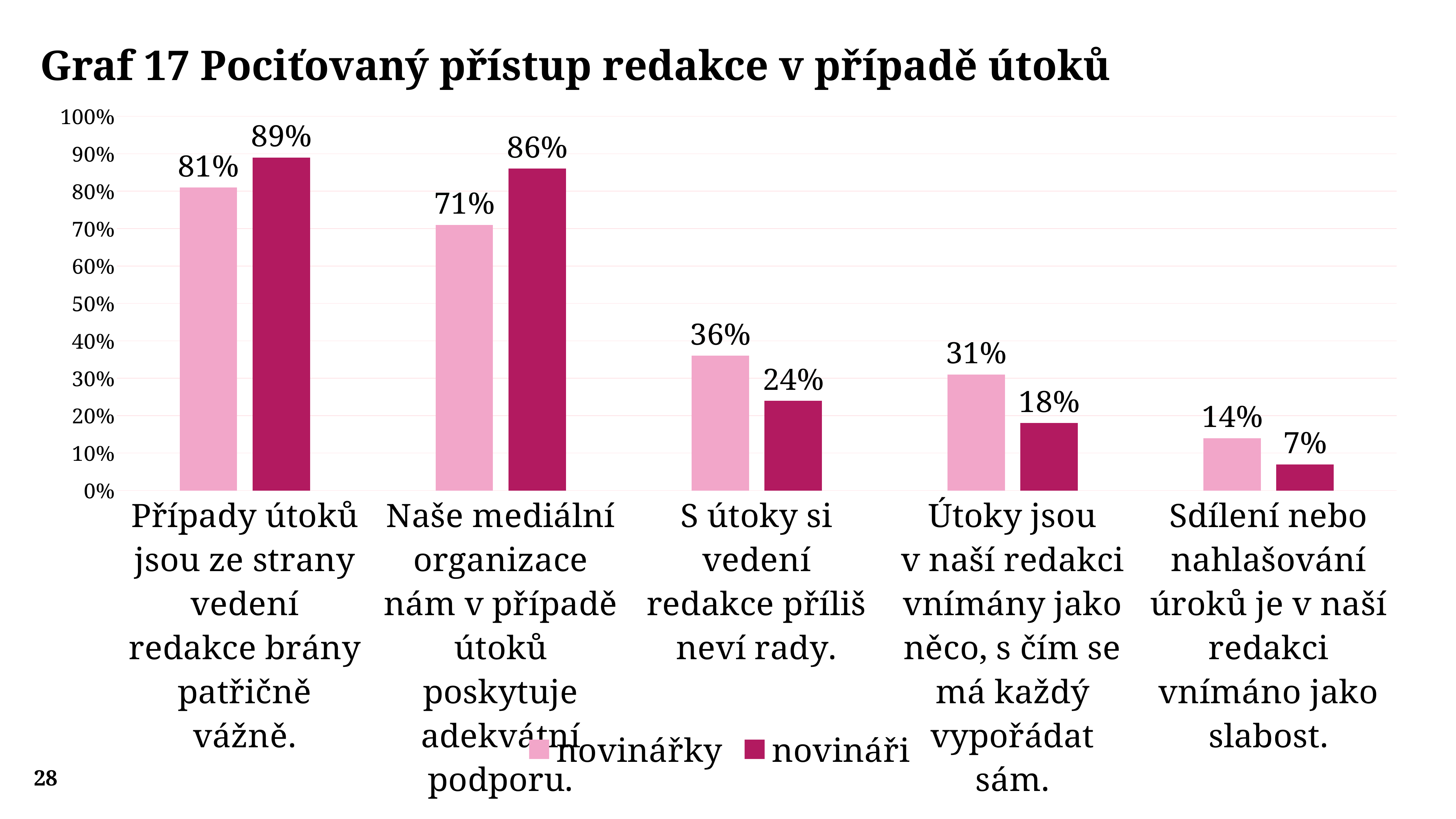
Is the value for novinářky for "Naše mediální organizace nám v případě útoků poskytuje adekvátní podporu." greater or less than 60%? greater What is the value for novinářky for "Případy útoků jsou ze strany vedení redakce brány patřičně vážně."? 81% What kind of chart is shown on the slide? bar chart How many categories are shown on the x axis? 5 Which category has the lowest value for novinářky? Sdílení nebo nahlašování úroků je v naší redakci vnímáno jako slabost. Which category has the highest value for novináři? Případy útoků jsou ze strany vedení redakce brány patřičně vážně. Which is larger for "Útoky jsou v naší redakci vnímány jako něco, s čím se má každý vypořádat sám.": novinářky or novináři? novinářky What is the title of the chart? Graf 17 Pociťovaný přístup redakce v případě útoků What is the difference between novinářky and novináři for "S útoky si vedení redakce příliš neví rady."? 12% How many series does the legend list? 2 What is the value for novináři for "Sdílení nebo nahlašování úroků je v naší redakci vnímáno jako slabost."? 7% What is the value for novináři for "Naše mediální organizace nám v případě útoků poskytuje adekvátní podporu."? 86%